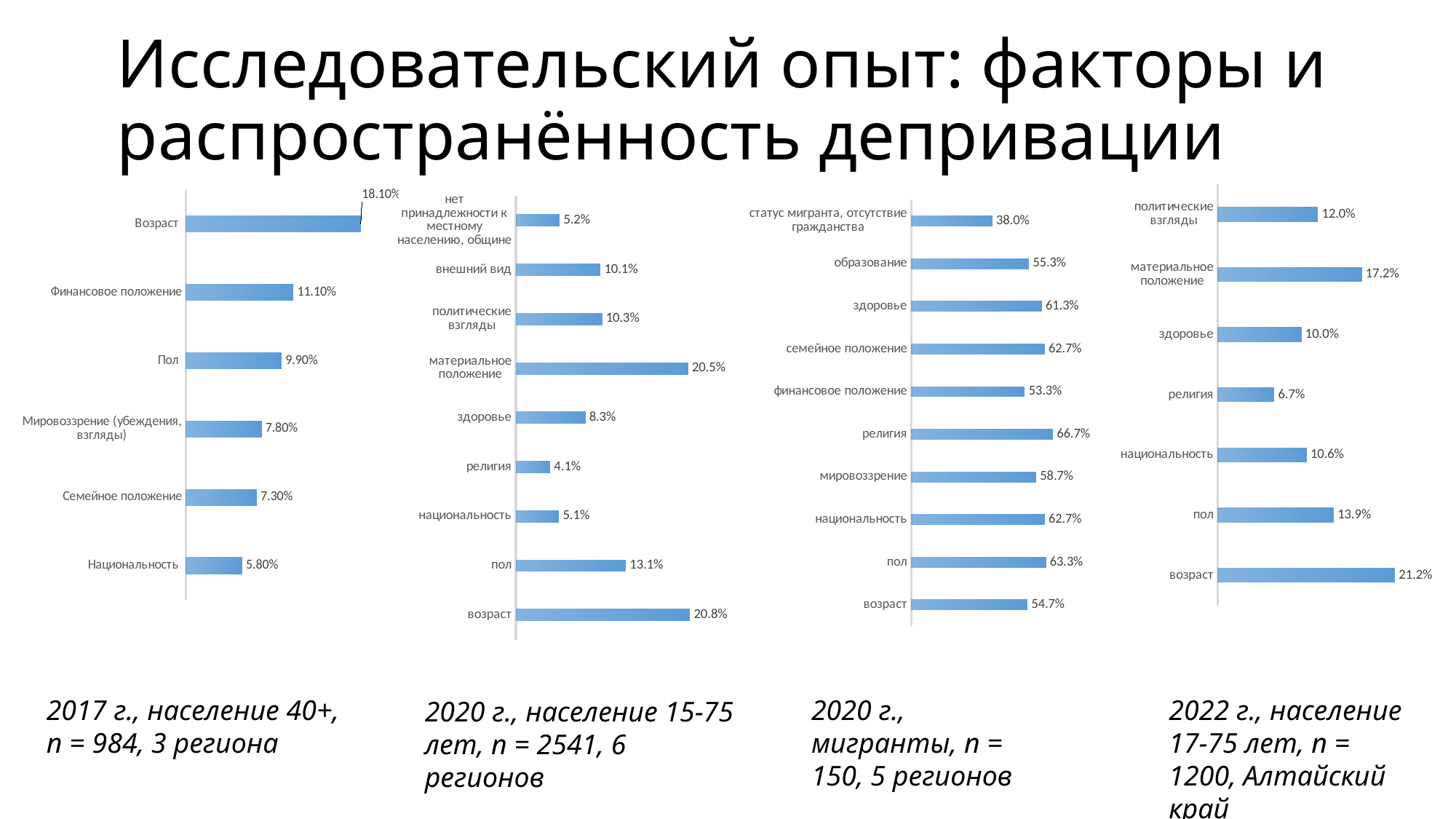
In the second chart from the left (2020, population 15-75), what is the difference between пол and национальность? 8.0% In the second chart from the left (2020, population 15-75), what is the value for материальное положение? 20.5% In the leftmost chart (2017, population 40+), which category has the lowest value? Национальность In the leftmost chart (2017, population 40+), how many categories are shown? 6 In the third chart from the left (2020, migrants), how many categories are shown? 10 In the third chart from the left (2020, migrants), what is the value for статус мигранта, отсутствие гражданства? 38.0% In the rightmost chart (2022, Алтайский край), which is larger: пол or здоровье? пол In the rightmost chart (2022, Алтайский край), what is the value for возраст? 21.2% What type of chart is the rightmost chart (2022, Алтайский край)? Bar chart In the third chart from the left (2020, migrants), which category has the highest value? религия In the second chart from the left (2020, population 15-75), which category has the lowest value? религия In the leftmost chart (2017, population 40+), what is the value for Возраст? 18.10%